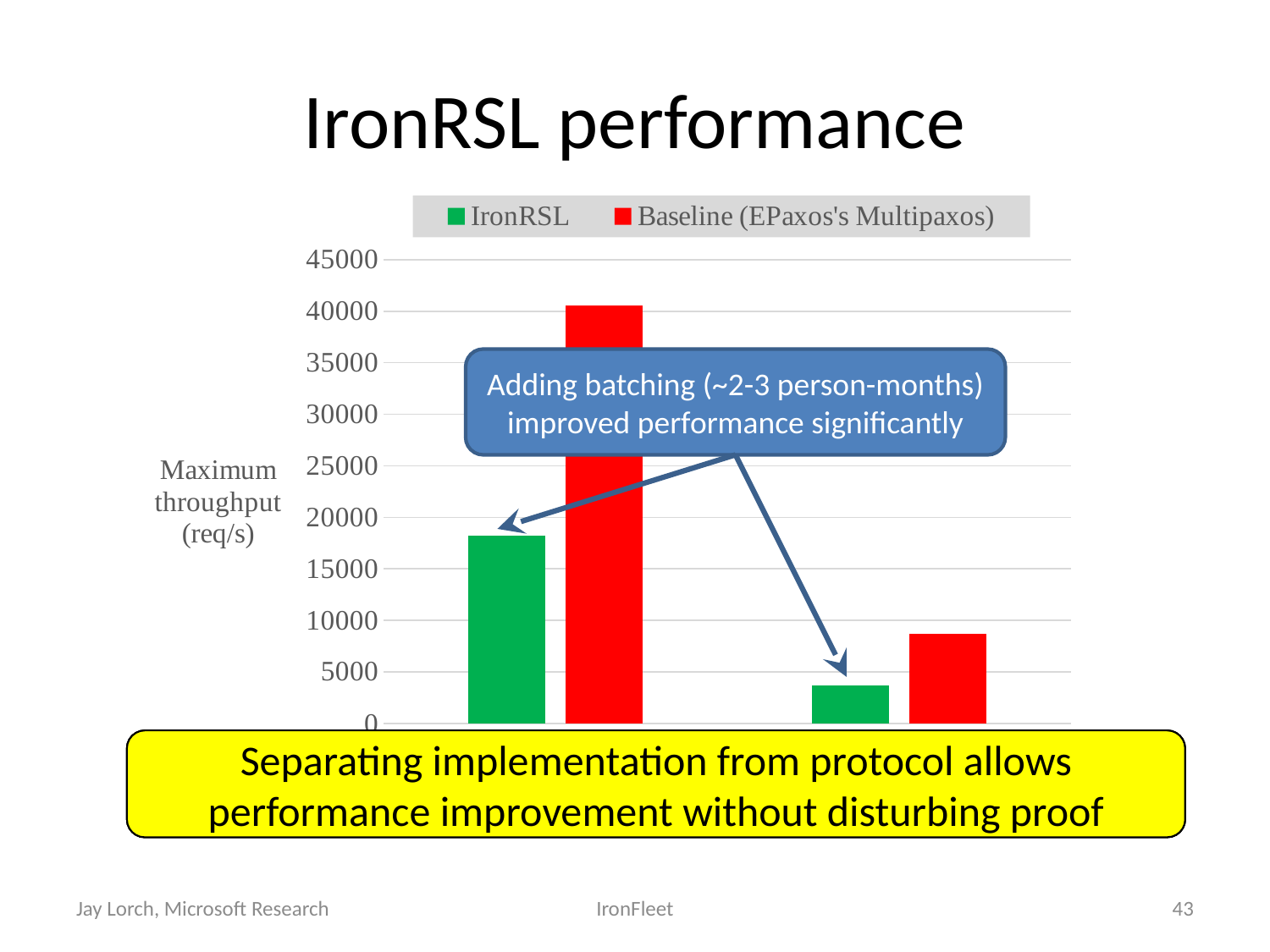
How many groups of bars are plotted in the chart? 2 What is the label on the vertical axis of the chart? Maximum throughput (req/s) In the left group of bars, which series has the larger value, IronRSL or Baseline (EPaxos's Multipaxos)? Baseline (EPaxos's Multipaxos) Is the IronRSL value in the right group of bars greater or less than 5000? less How many series does the legend list? 2 Is the Baseline (EPaxos's Multipaxos) value in the left group of bars greater or less than 35000? greater Is the Baseline (EPaxos's Multipaxos) value in the right group of bars greater or less than 10000? less What are the two series named in the legend? IronRSL and Baseline (EPaxos's Multipaxos) Which bar in the chart is the tallest? Baseline (EPaxos's Multipaxos) in the left group What kind of chart is shown on the slide? bar chart